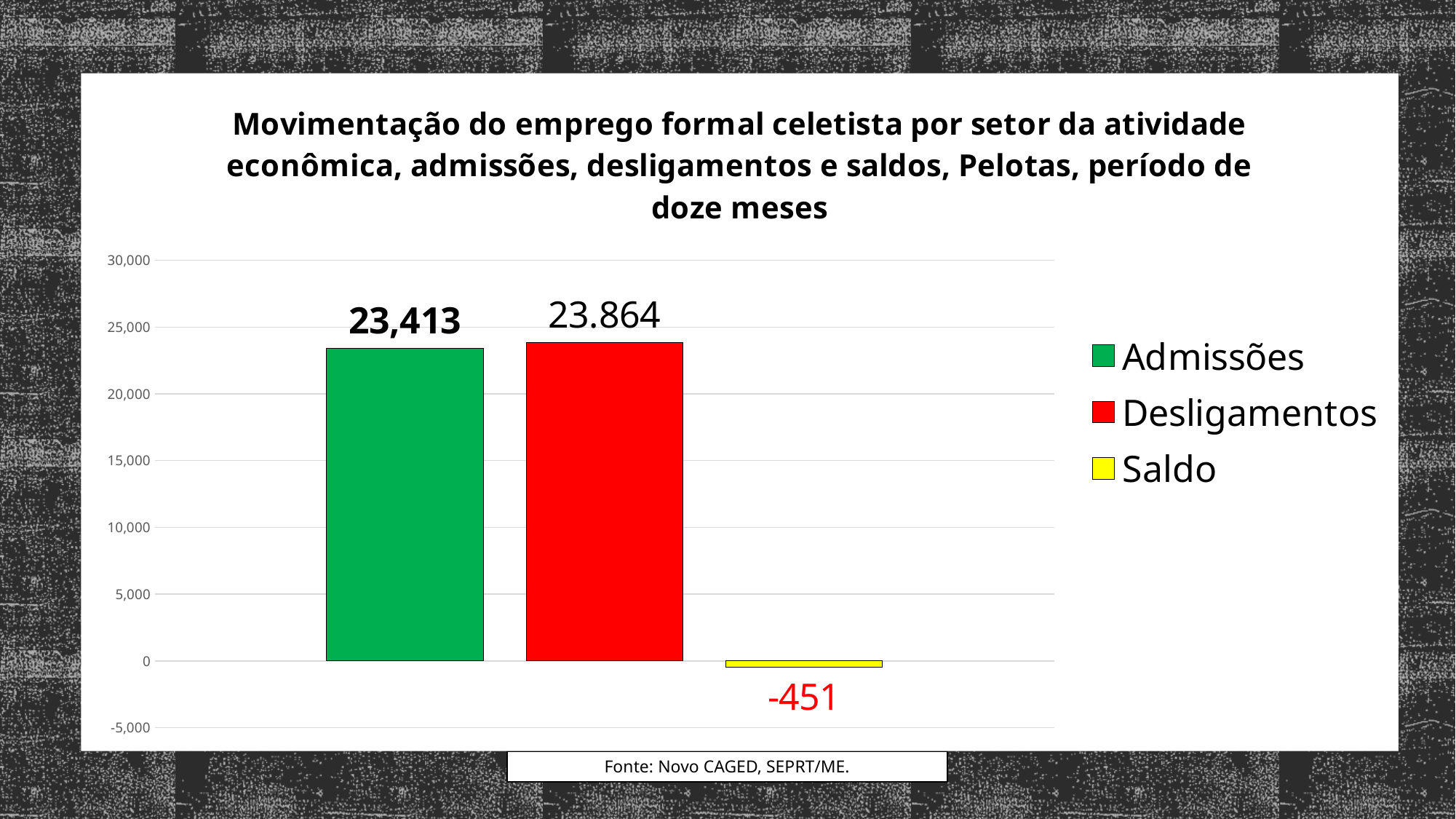
Which series has the lowest value? Saldo Which is larger, Admissões or Desligamentos? Desligamentos What is the value shown for Saldo? -451 What is the difference between Desligamentos and Admissões? 451 What colour is the bar for Saldo? yellow What is the value shown for Admissões? 23,413 How many series does the legend list? 3 What is the value shown for Desligamentos? 23.864 Which series has the highest value? Desligamentos How many bars are plotted in the chart? 3 What kind of chart is shown on the slide? bar chart Is the value for Admissões greater or less than 20,000? greater